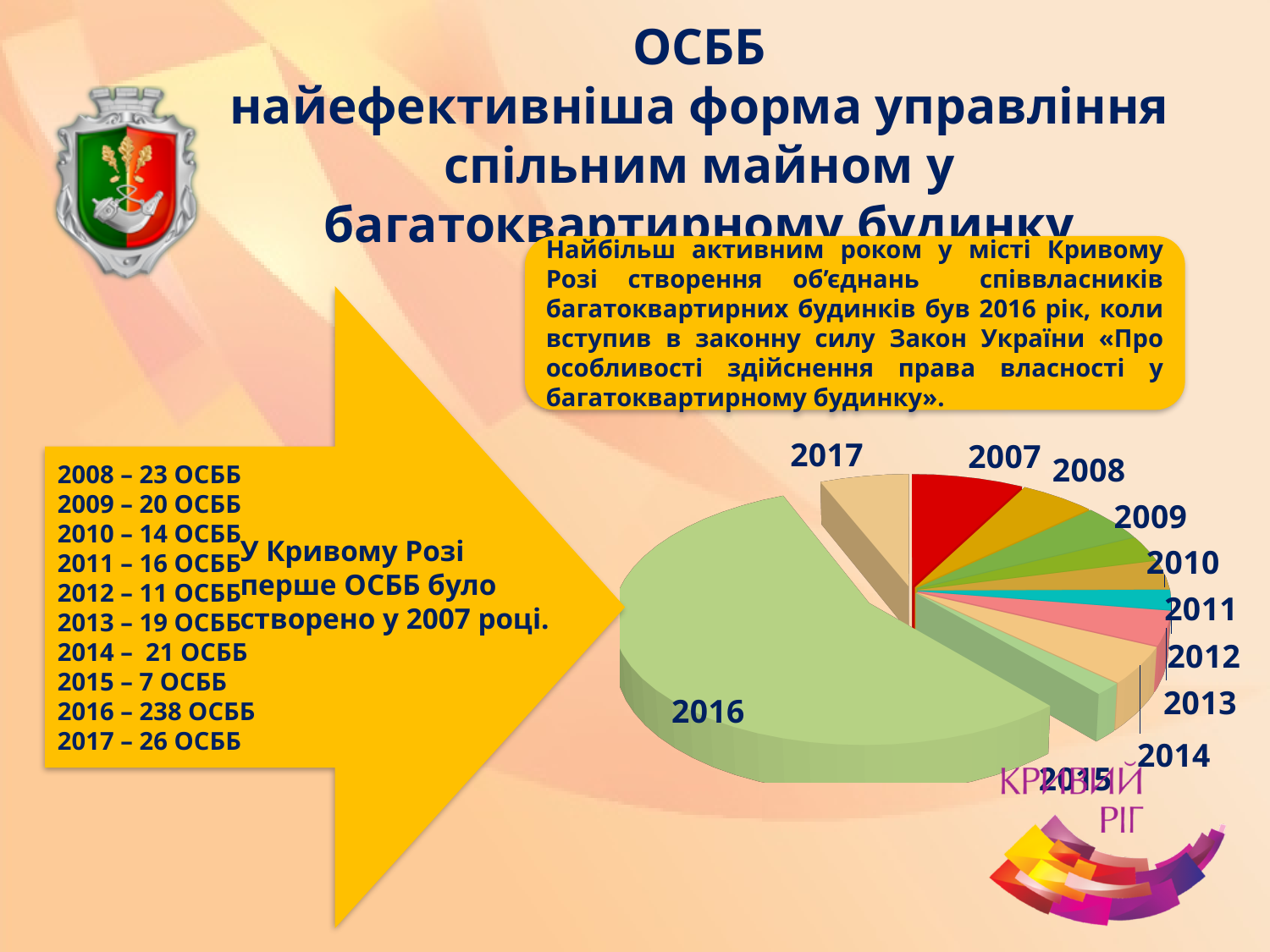
Which year has the smallest slice in the pie chart? 2015 What colour is the 2007 slice of the pie chart? red What colour is the 2016 slice of the pie chart? light green According to the slide, how many ОСББ were created in 2017? 26 ОСББ Which slice is larger, 2008 or 2015? 2008 According to the slide, how many ОСББ were created in 2016? 238 ОСББ What is the difference between the number of ОСББ created in 2016 and in 2017? 212 What kind of chart is shown on the slide? pie chart Which slice is larger, 2016 or 2017? 2016 According to the slide, how many ОСББ were created in 2015? 7 ОСББ Which year has the largest slice in the pie chart? 2016 How many year slices does the pie chart have? 11